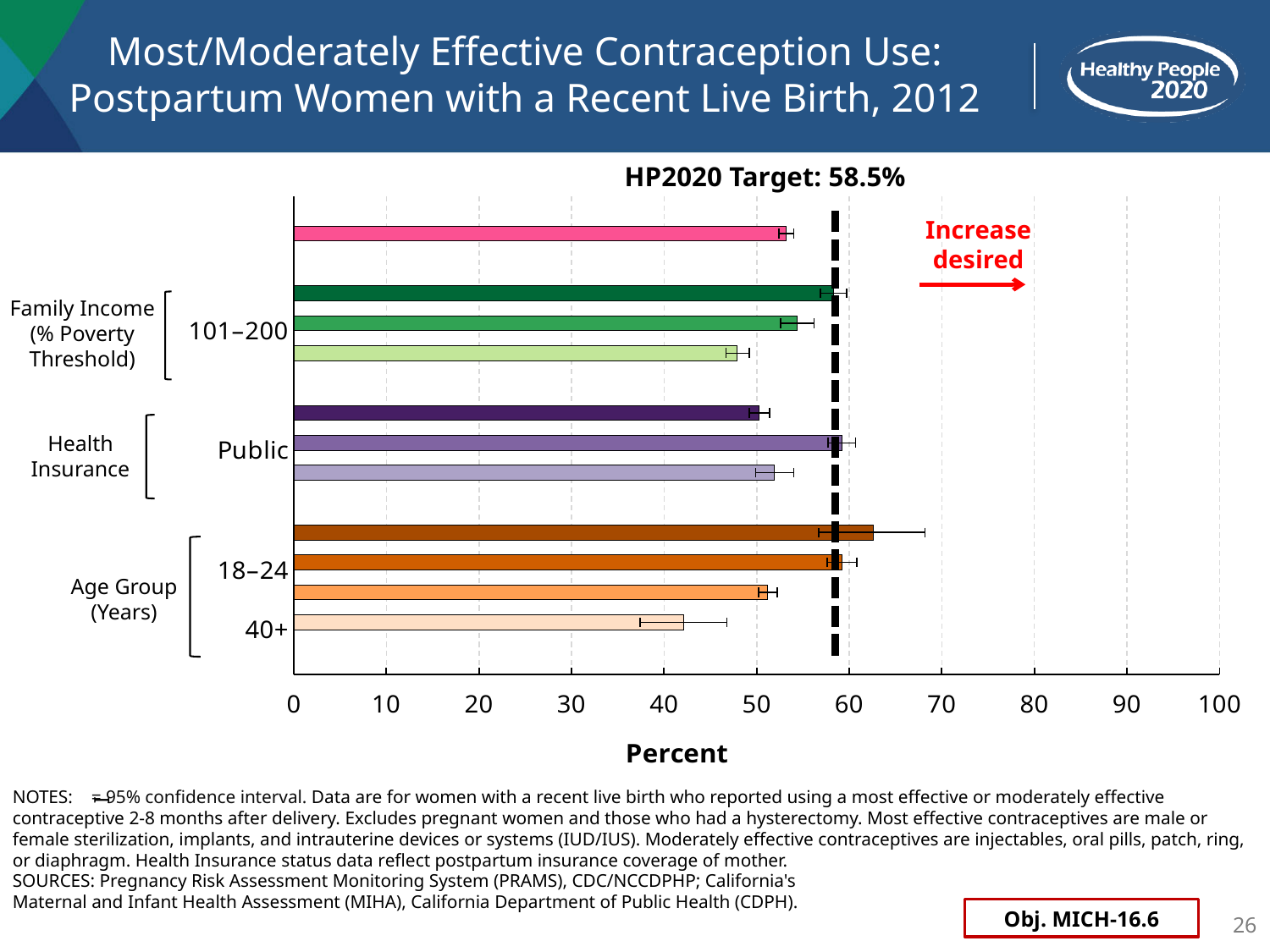
What is the label of the x axis? Percent Which has the larger value, the 101–200 family income group or the 40+ age group? 101–200 What is the HP2020 Target value shown above the chart? 58.5% What kind of chart is shown on the slide? bar chart Which labeled category has the lowest value on the chart? 40+ Which has the larger value, the 18–24 age group or the 40+ age group? 18–24 Is the value for Public health insurance greater or less than 50? greater Is the value for the 18–24 age group greater or less than 50? greater Is the value for the 101–200 family income group greater or less than 60? less How many bars are plotted on the chart? 11